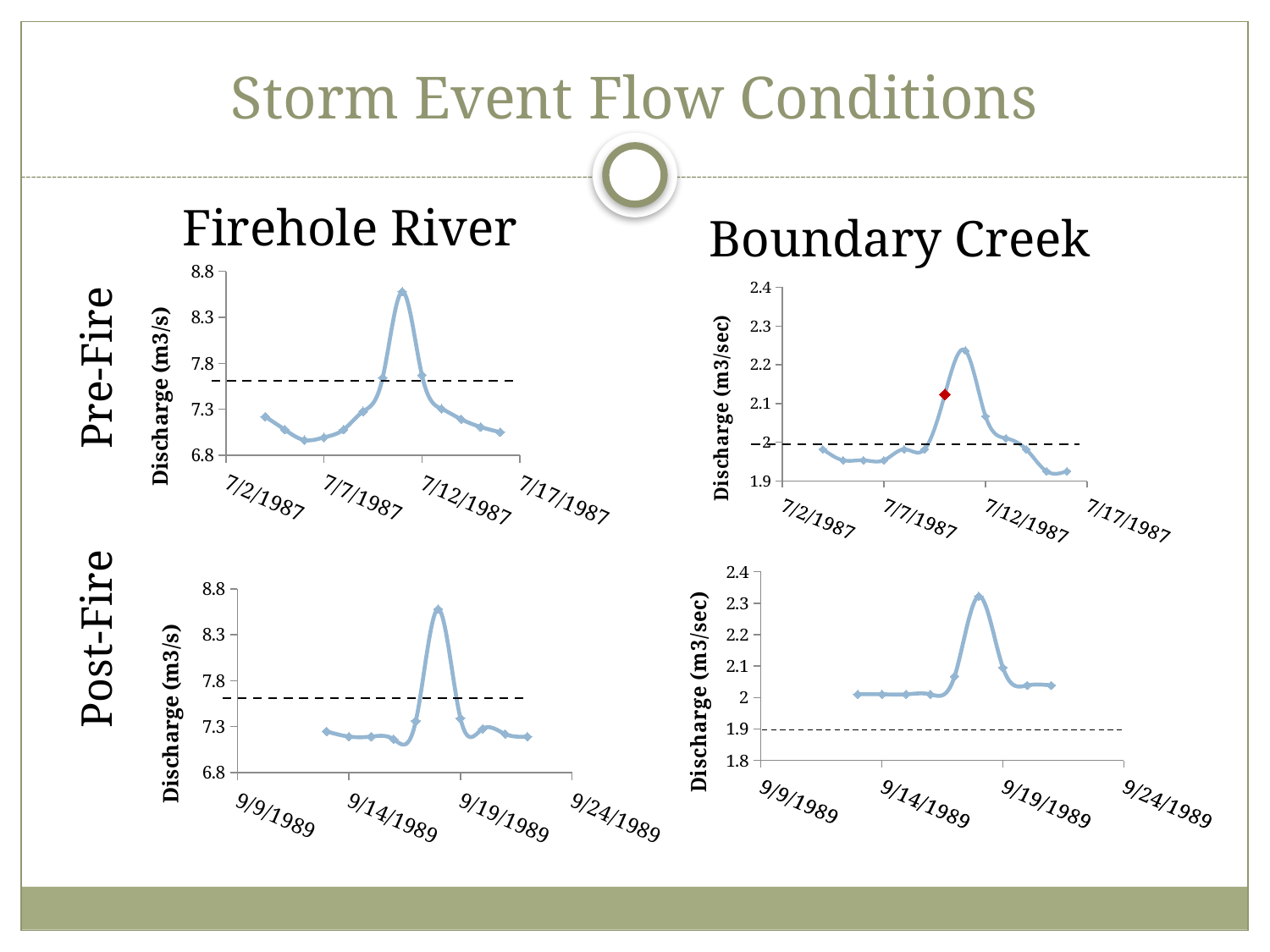
In the Boundary Creek Post-Fire chart (bottom-right), are the discharge values at the start of the series greater or less than 1.9? greater What is the highest value shown on the y-axis of the Boundary Creek Pre-Fire chart (top-right)? 2.4 In the Firehole River Post-Fire chart (bottom-left), is the peak discharge value greater or less than 8.3? greater In the Boundary Creek Pre-Fire chart (top-right), is the peak discharge value greater or less than 2.1? greater What kind of chart is the Firehole River Pre-Fire chart (top-left)? Line chart What is the y-axis label on the Firehole River charts? Discharge (m3/s) How many charts are shown on the slide? 4